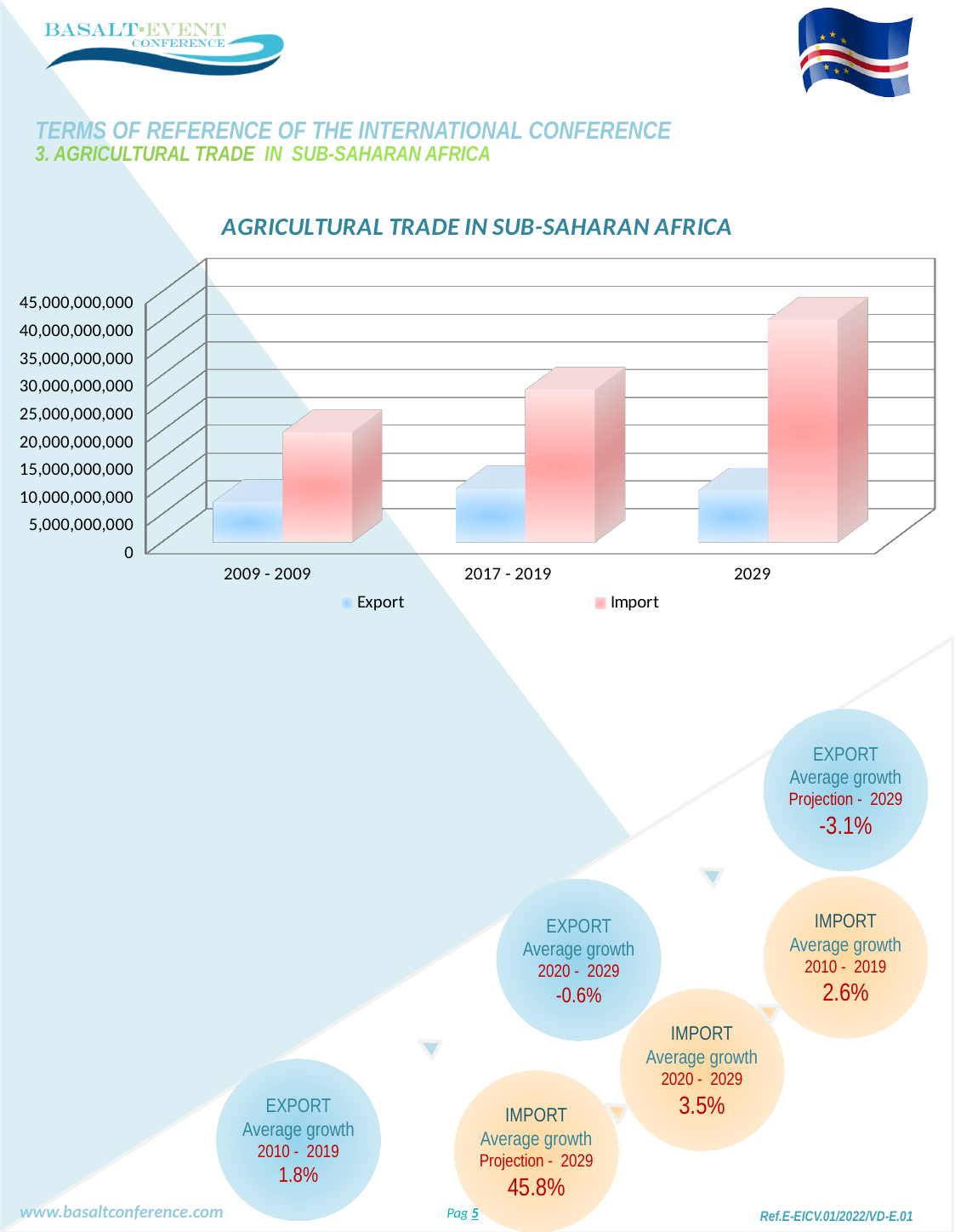
In which category is the Import value lowest? 2009 - 2009 What kind of chart is shown on the slide? bar chart How many categories are shown on the x axis of the chart? 3 In which category is the Import value highest? 2029 In 2029, which is larger, Export or Import? Import How many series does the chart legend list? 2 Which two series are listed in the chart legend? Export and Import What is the title of the chart? AGRICULTURAL TRADE IN SUB-SAHARAN AFRICA Do the Import values rise or fall from 2009 - 2009 to 2029? rise Is the Import value for 2029 greater or less than 35,000,000,000? greater Is the Import value for 2009 - 2009 greater or less than 25,000,000,000? less Is the Export value for 2009 - 2009 greater or less than 15,000,000,000? less